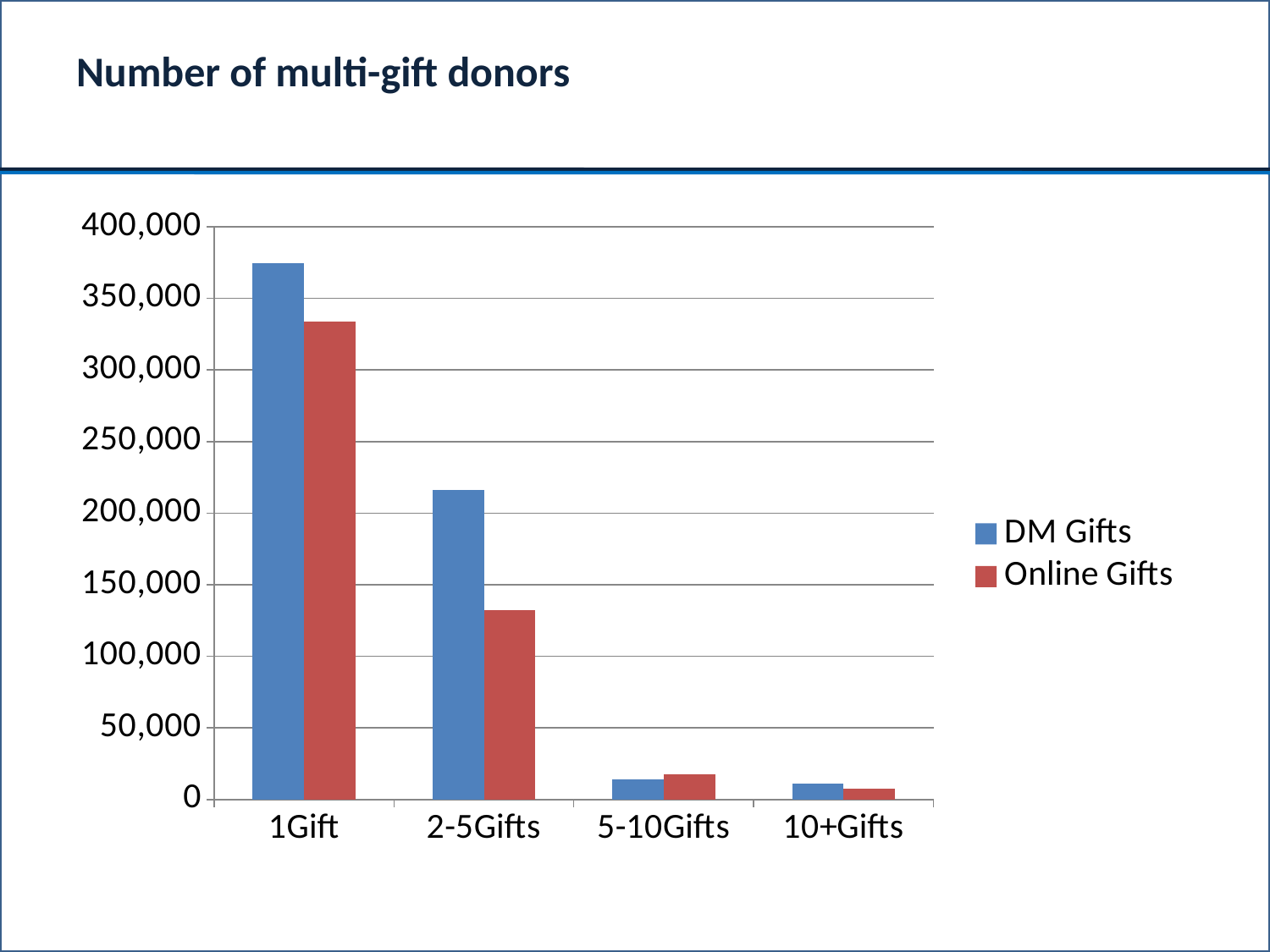
Which colour represents Online Gifts in the legend? red Do the DM Gifts values rise or fall moving from 1Gift to 10+Gifts along the x axis? fall Which category has the lowest value for Online Gifts? 10+Gifts Is the value for Online Gifts at 2-5Gifts greater or less than 150,000? less How many categories are shown on the x axis? 4 Which category has the highest value for DM Gifts? 1Gift What is the title of the slide's chart? Number of multi-gift donors How many series does the legend list? 2 What type of chart is shown on the slide? bar chart Is the value for DM Gifts at 2-5Gifts greater or less than 200,000? greater Which is larger at 1Gift, DM Gifts or Online Gifts? DM Gifts Is the value for DM Gifts at 1Gift greater or less than 350,000? greater